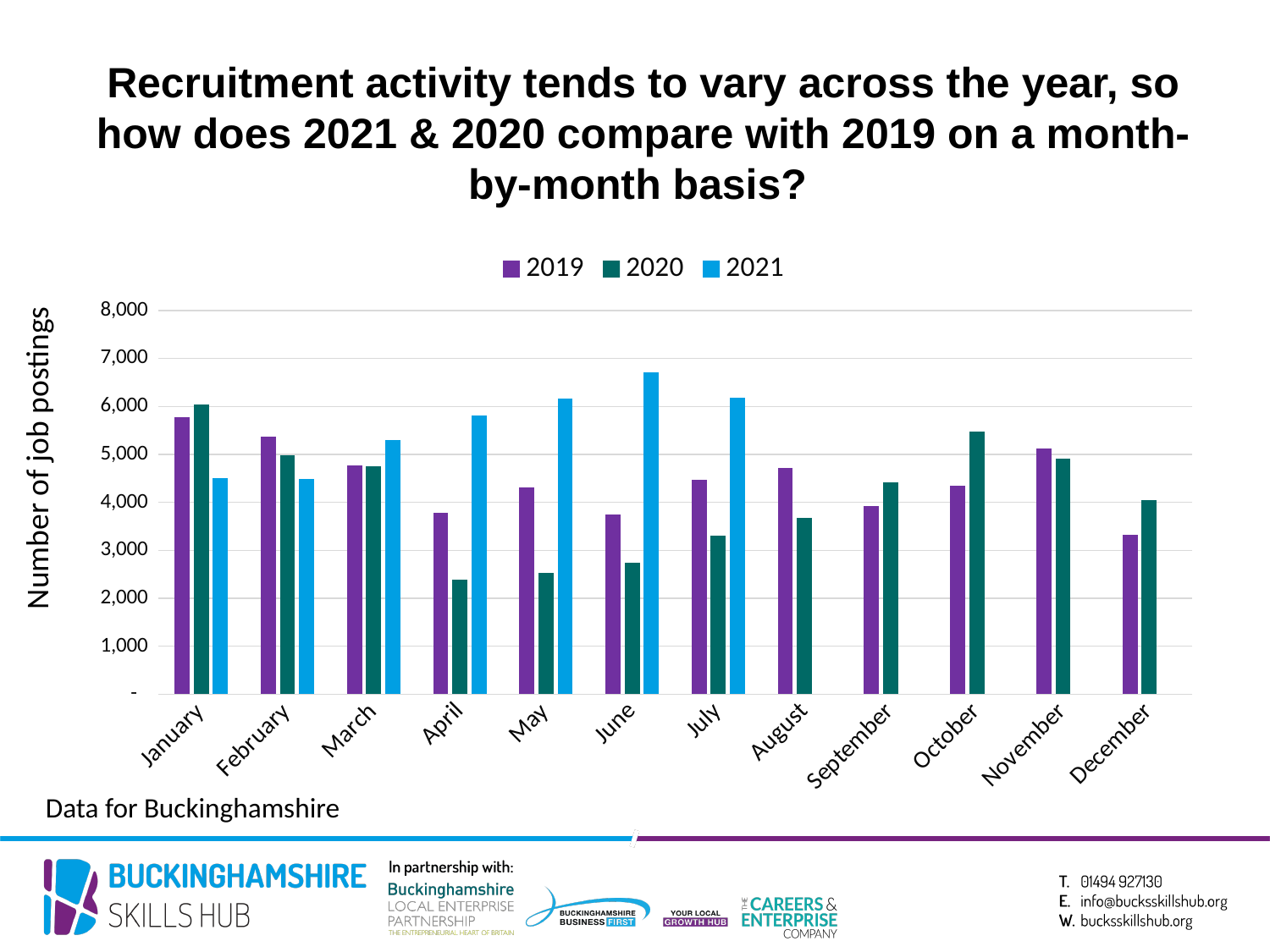
Is the value for April 2020 greater or less than 3,000? less Which month has the highest value for the 2021 series? June Is the value for June 2021 greater or less than 6,000? greater Do the 2021 values rise or fall from January to June? rise In April, which series has the larger value, 2019 or 2021? 2021 What is the label on the vertical axis? Number of job postings How many series does the legend list? 3 What kind of chart is shown on the slide? bar chart How many months are shown along the x axis? 12 Which month has the lowest value for the 2019 series? December In January, which series has the larger value, 2019 or 2021? 2019 Which month has the highest value for the 2020 series? January